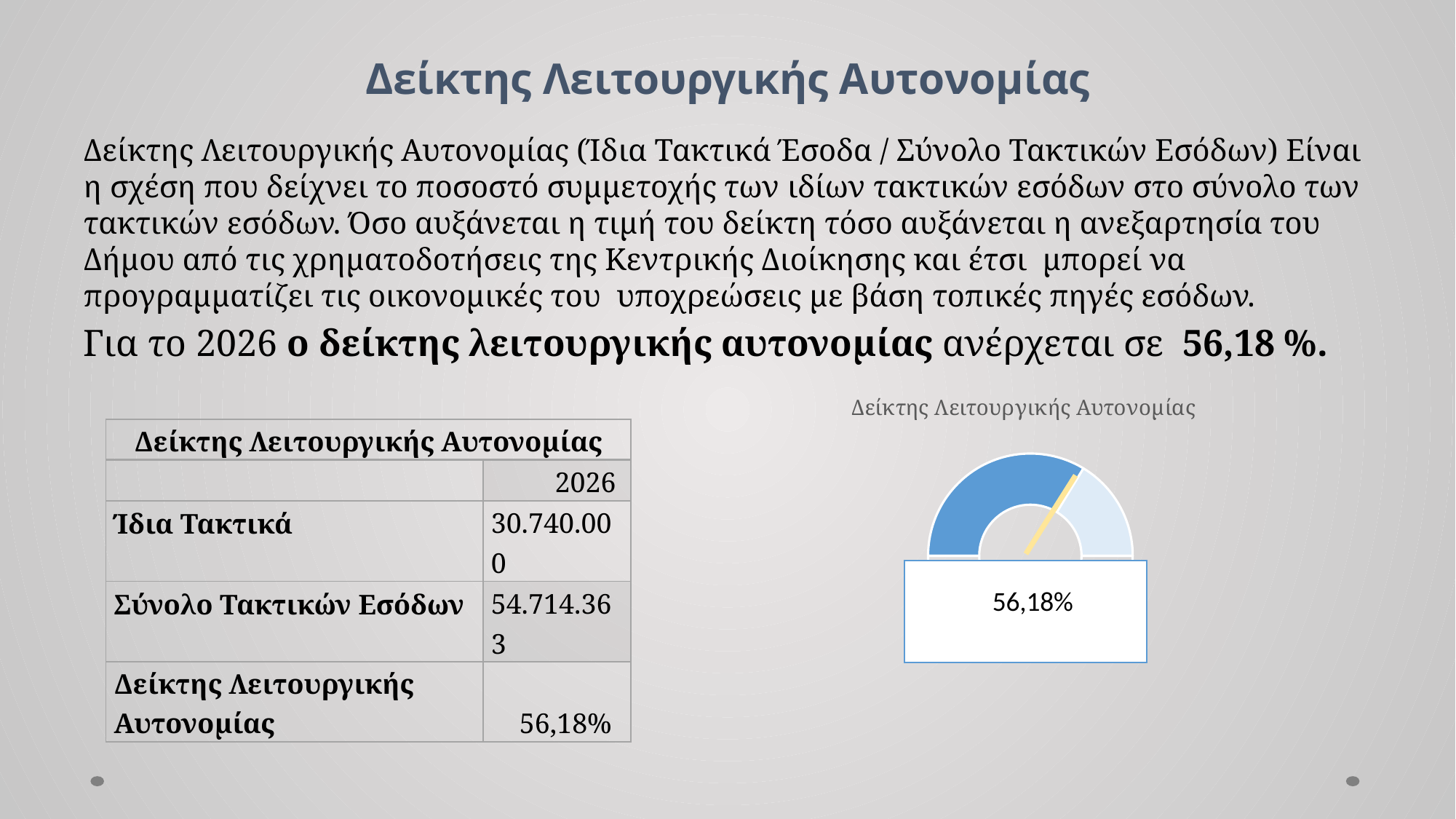
What colour is the filled portion of the gauge chart? blue What value does the gauge chart display? 56,18% Is the value shown on the gauge chart greater or less than 50%? greater What kind of chart is shown on the right side of the slide? gauge chart How many values are plotted on the gauge chart? 1 What is the title of the chart on the right side of the slide? Δείκτης Λειτουργικής Αυτονομίας